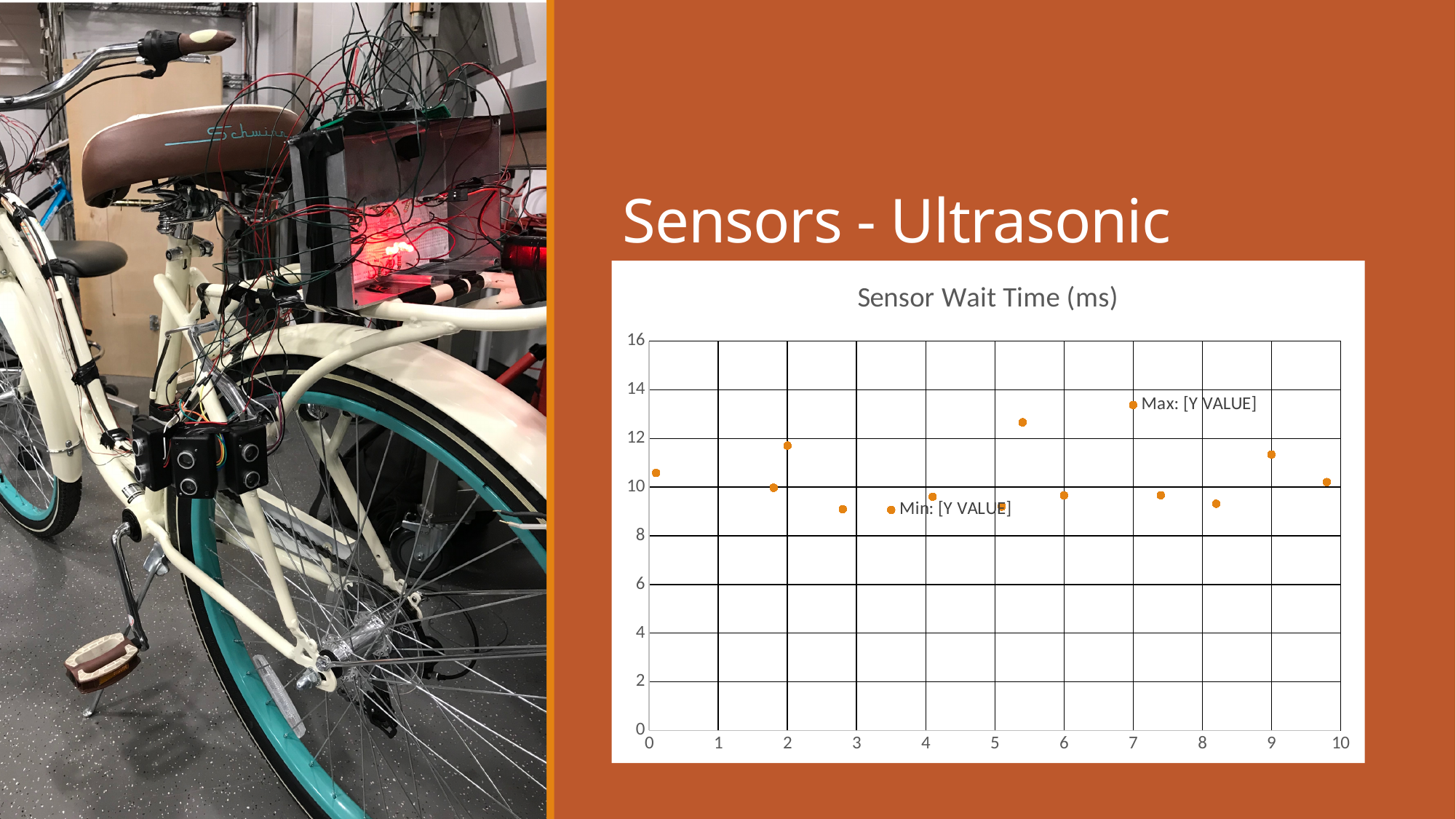
Which point has the lower value: the one near x = 3.5 or the one near x = 5.4? the one near x = 3.5 Are any of the plotted points below 8 on the vertical axis? No What kind of chart is shown on the slide? scatter chart Which point has the higher value: the one near x = 7 or the one near x = 8.2? the one near x = 7 What is the title of the chart? Sensor Wait Time (ms) What is the highest value shown on the vertical axis of the chart? 16 Is the value of the point near x = 3.5 greater or less than 10? less Is the value of the point near x = 8.2 greater or less than 10? less